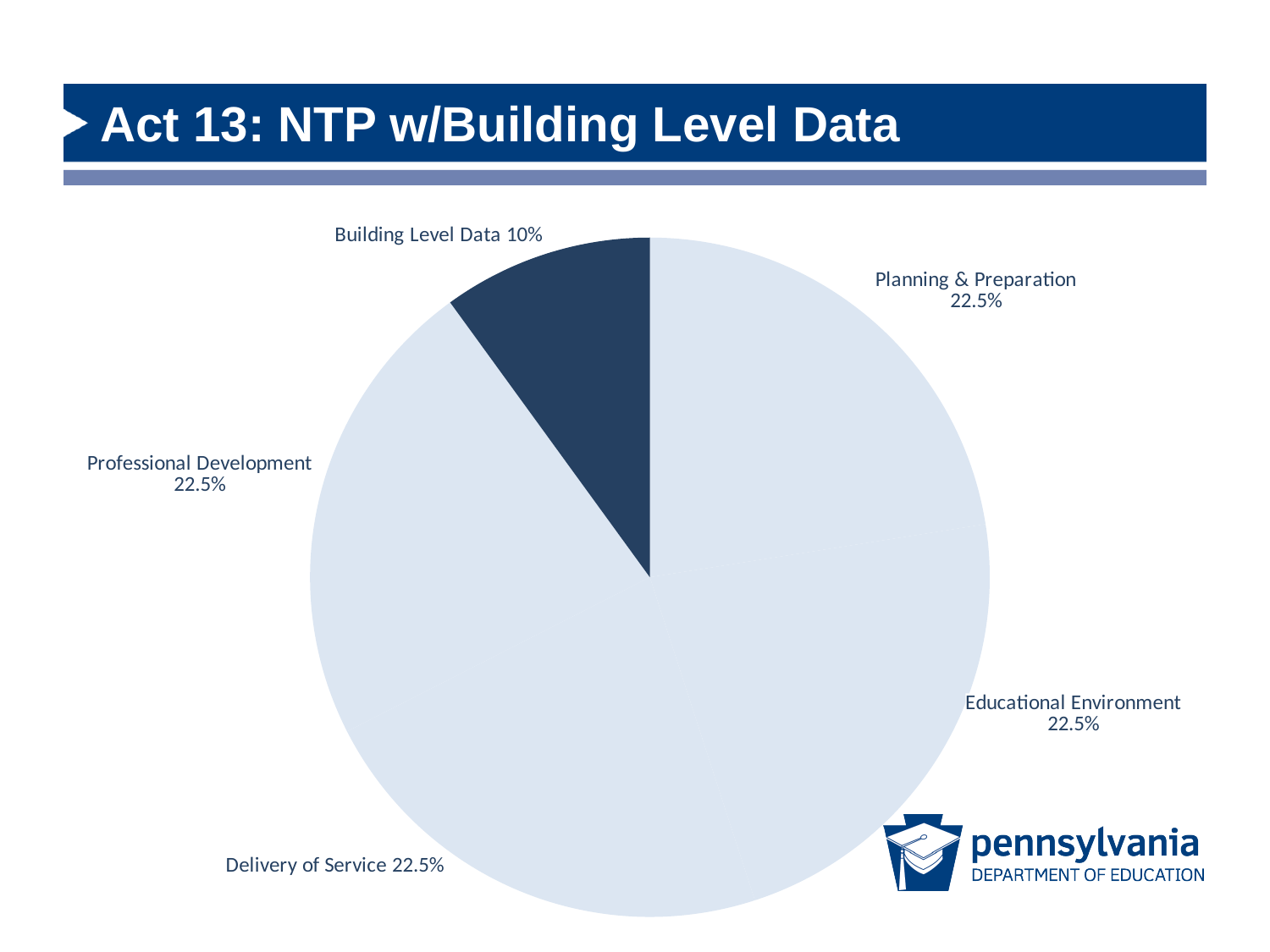
What is the title of the slide containing the pie chart? Act 13: NTP w/Building Level Data Which is larger, the value for Delivery of Service or the value for Building Level Data? Delivery of Service What is the value for Delivery of Service? 22.5% What share of the pie does Building Level Data represent? 10% What is the value for Professional Development? 22.5% What is the combined total of the four 22.5% categories? 90% What is the value for Educational Environment? 22.5% What is the value for Planning & Preparation? 22.5% How many categories are shown in the pie chart? 5 Which category has the smallest slice of the pie? Building Level Data What is the difference between the Planning & Preparation value and the Building Level Data value? 12.5% What kind of chart is shown on the slide? Pie chart